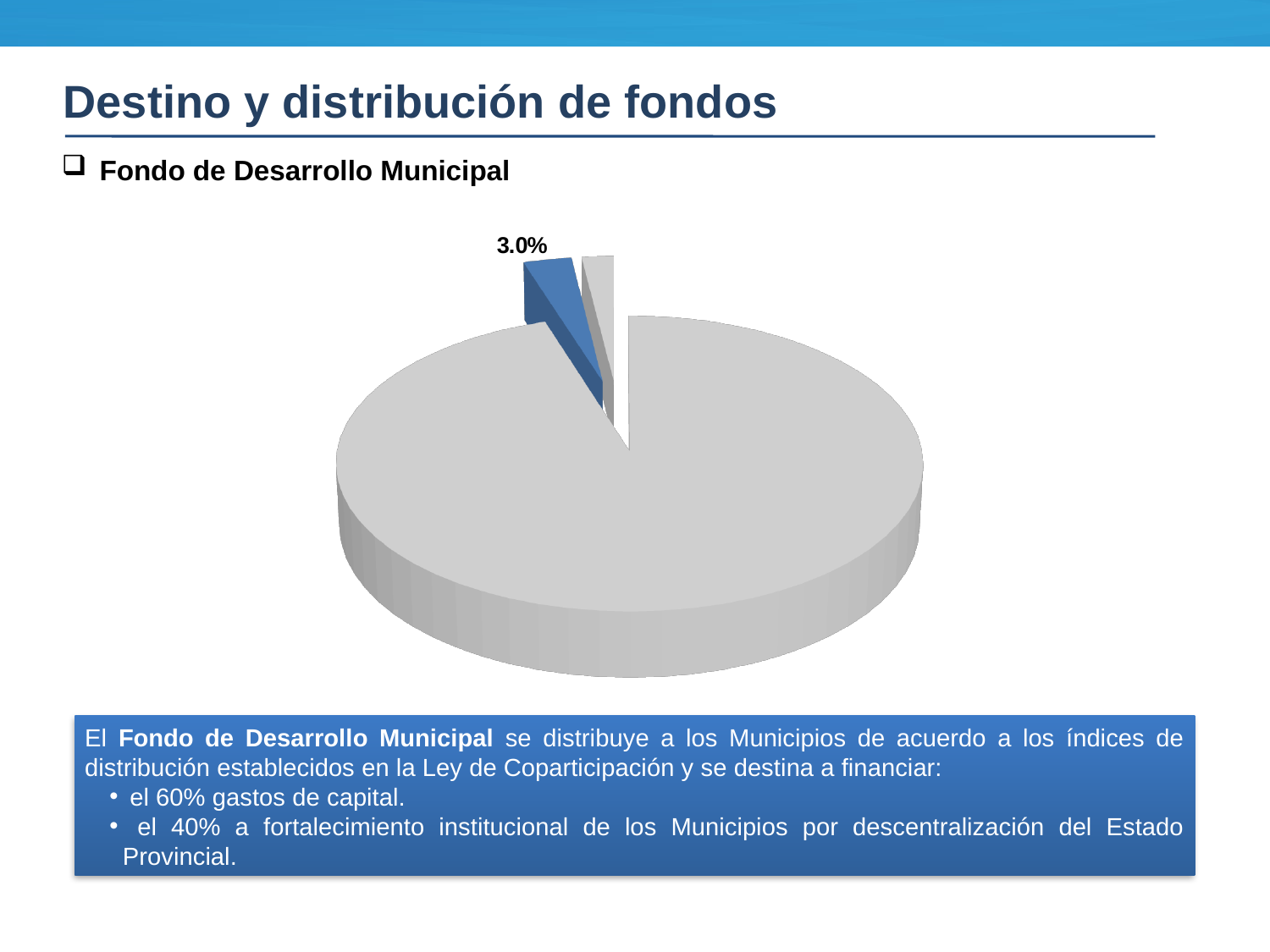
How many data labels are printed on the pie chart? 1 Which slice of the pie chart is the largest: the blue slice or the large grey slice? the large grey slice Is the blue slice labelled 3.0% larger or smaller than the large grey slice? smaller What percentage is printed as the data label on the blue slice of the pie chart? 3.0% How many slices does the pie chart show? 3 What kind of chart is shown on the slide? pie chart What colour is the slice labelled 3.0% in the pie chart? blue